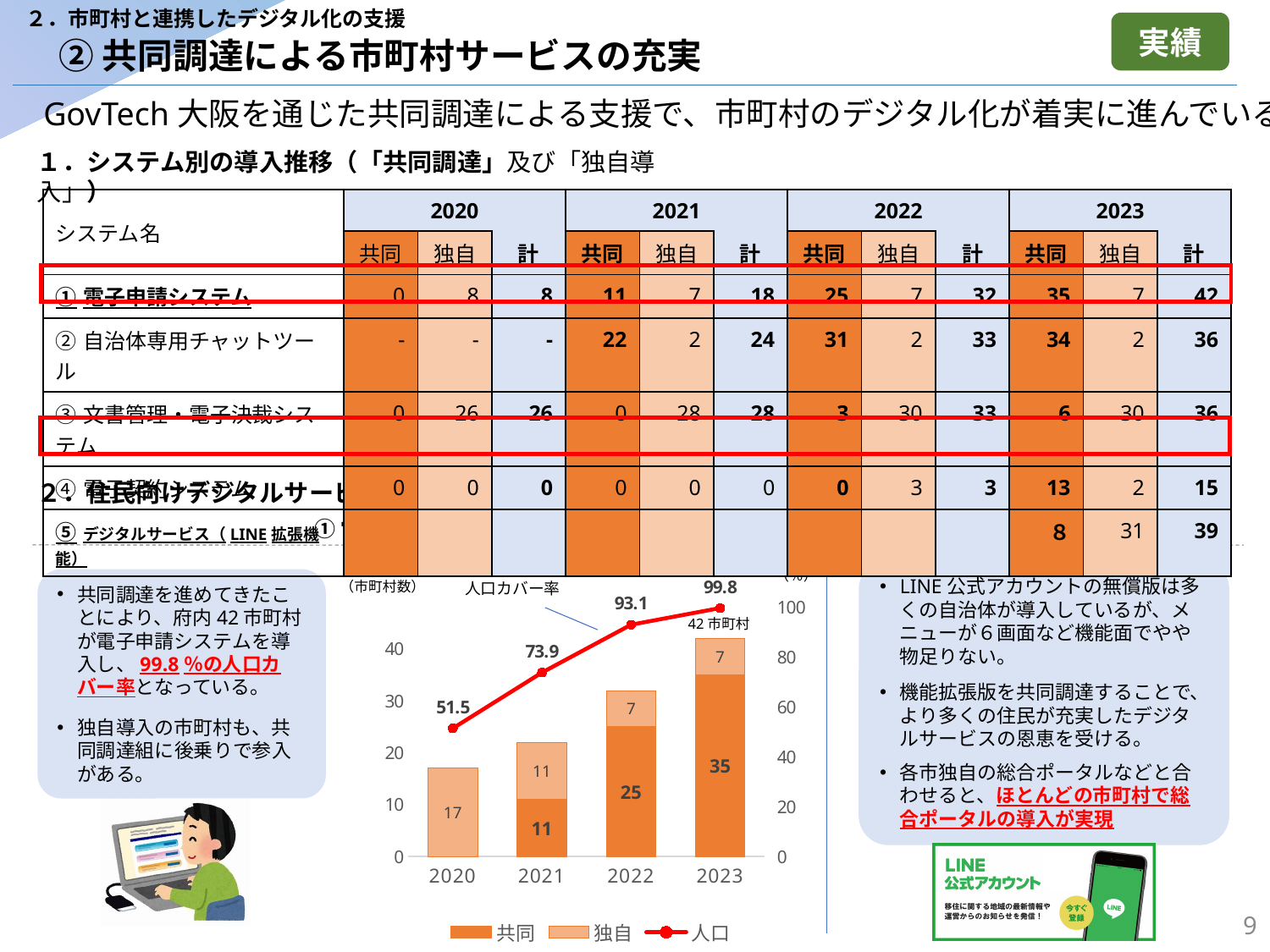
In the bottom-centre chart, what is the value of 独自 for 2020? 17 In the bottom-centre chart, what is the 人口 line value for 2020? 51.5 In the bottom-centre chart, what is the total of the stacked bar for 2023? 42 In the bottom-centre chart, what is the value of 独自 for 2021? 11 How many years are shown on the x axis of the bottom-centre chart? 4 How many series does the legend of the bottom-centre chart list? 3 In the bottom-centre chart, in which year is the 人口 line highest? 2023 In the bottom-centre chart, what is the value of 共同 for 2023? 35 In the bottom-centre chart, what is the 人口 line value for 2023? 99.8 What kind of chart is shown at the bottom centre of the slide? A stacked bar chart with a line In the bottom-centre chart, does the 人口 line rise or fall from 2020 to 2023? Rises In the bottom-centre chart, what is the difference between the 共同 values for 2023 and 2022? 10